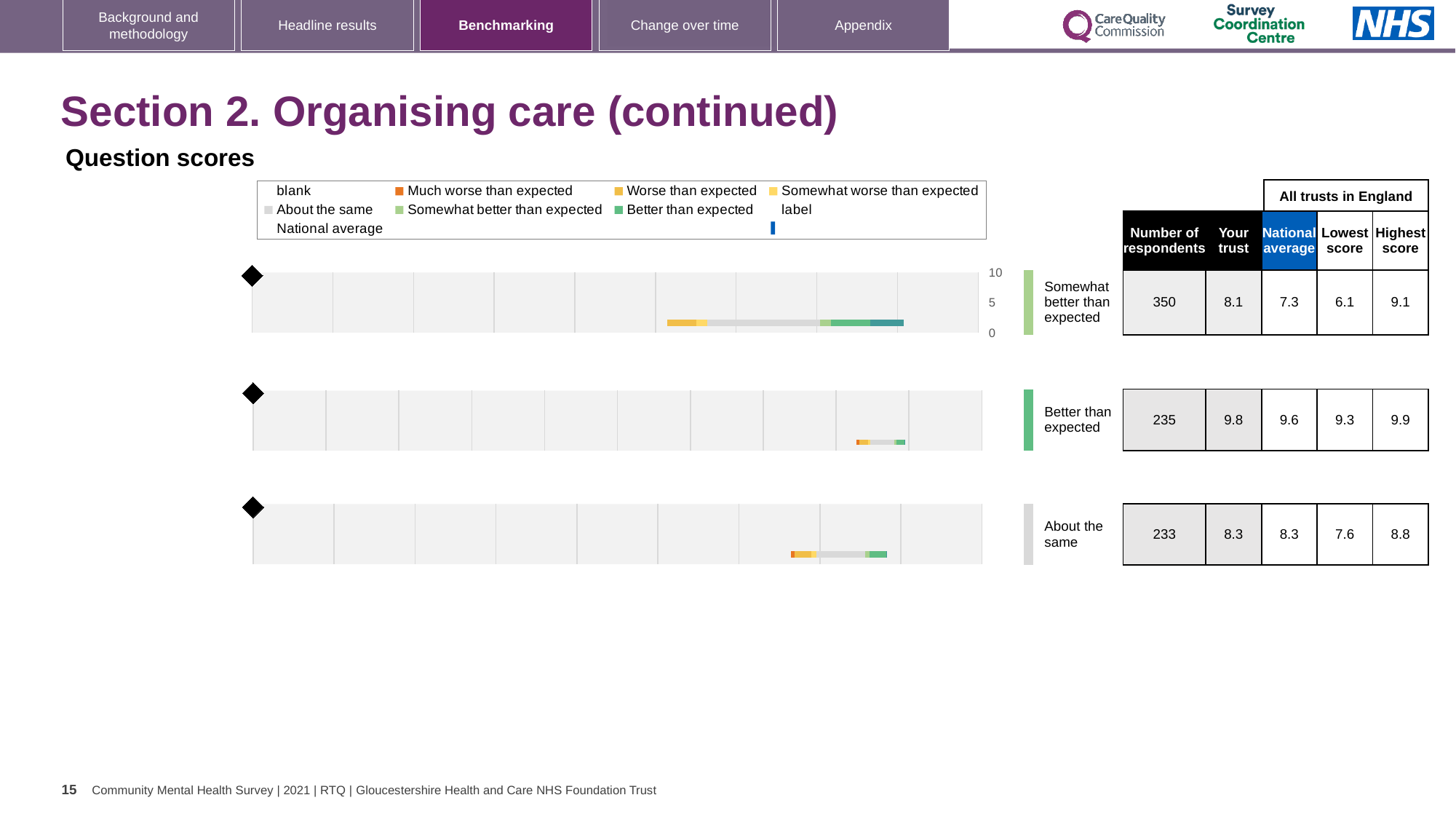
For the middle chart, what is the highest score among all trusts in England? 9.9 For the middle chart, which is larger: the 'Your trust' score or the national average? Your trust (9.8) For the bottom chart, how many respondents are there? 233 What kind of chart is used for each question score on the slide? Bar chart For the top chart, is the 'Your trust' score greater or less than 5? greater What benchmark category is the middle chart labelled with? Better than expected How many charts are shown on the slide? 3 Which of the three charts has the highest 'Your trust' score? The middle chart (9.8) For the top chart, what is the difference between the 'Your trust' score and the national average? 0.8 Which of the three charts has the lowest number of respondents? The bottom chart (233) For the top chart, what is the national average score? 7.3 For the top chart, what is the 'Your trust' score? 8.1